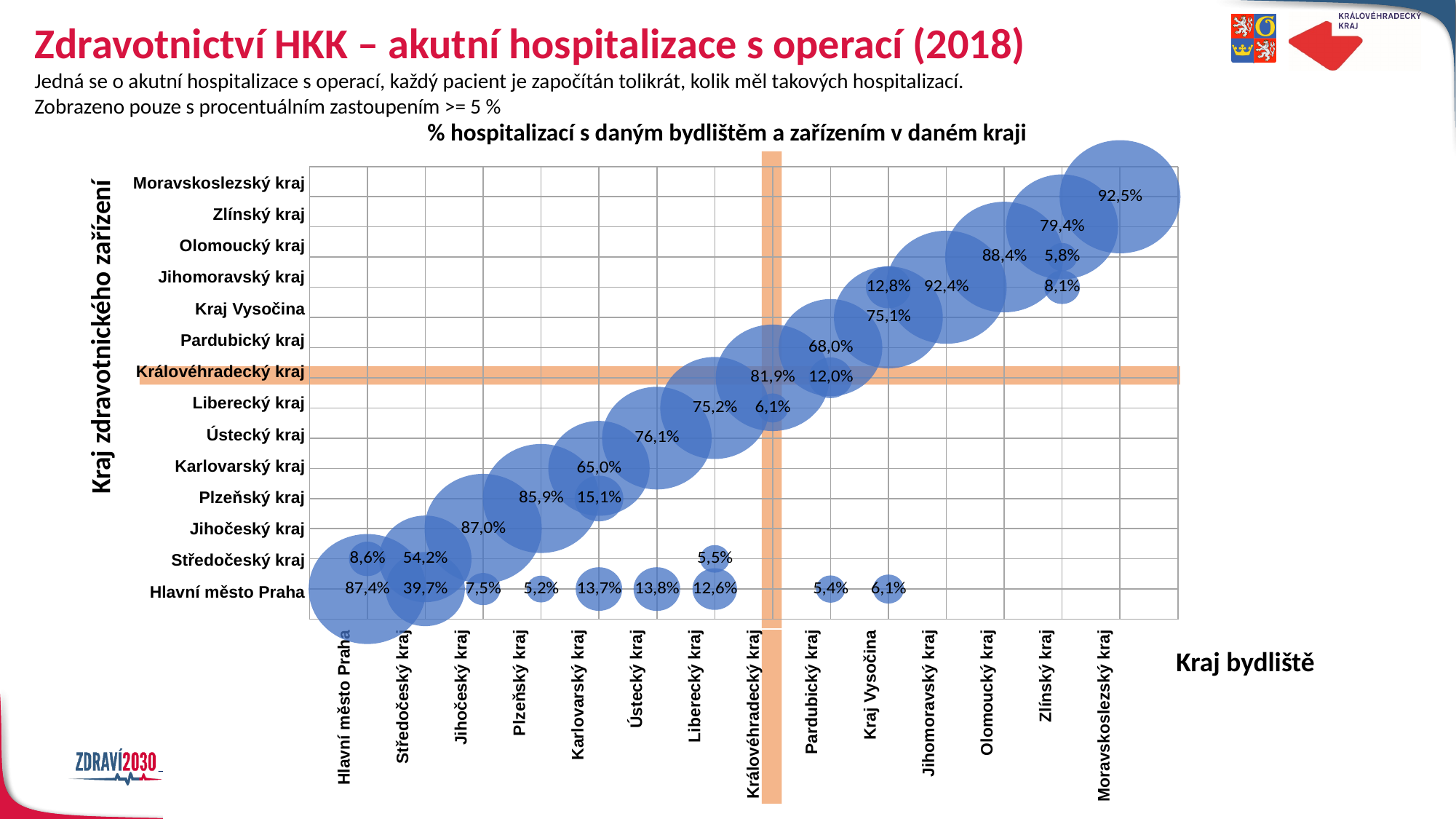
What percentage is shown for patients living in Pardubický kraj who were hospitalized in a facility in Královéhradecký kraj? 12,0% Which is the smallest percentage value labelled on the chart? 5,2% Which is larger: the percentage for Středočeský kraj residents hospitalized in Středočeský kraj, or the percentage for Karlovarský kraj residents hospitalized in Karlovarský kraj? Karlovarský kraj (65,0%) What is the difference between the percentage for Hlavní město Praha residents hospitalized in Hlavní město Praha (87,4%) and Středočeský kraj residents hospitalized in Hlavní město Praha (39,7%)? 47,7% What percentage is shown for patients living in Hlavní město Praha who were hospitalized in a facility in Hlavní město Praha? 87,4% What kind of chart is shown on the slide? bubble chart How many regions (kraje) are listed along the horizontal axis? 14 What is the chart's title? % hospitalizací s daným bydlištěm a zařízením v daném kraji What percentage is shown for patients living in Moravskoslezský kraj who were hospitalized in a facility in Moravskoslezský kraj? 92,5% What percentage is shown for patients living in Středočeský kraj who were hospitalized in a facility in Hlavní město Praha? 39,7% What percentage is shown for patients living in Královéhradecký kraj who were hospitalized in a facility in Královéhradecký kraj? 81,9% What is the label of the horizontal axis? Kraj bydliště